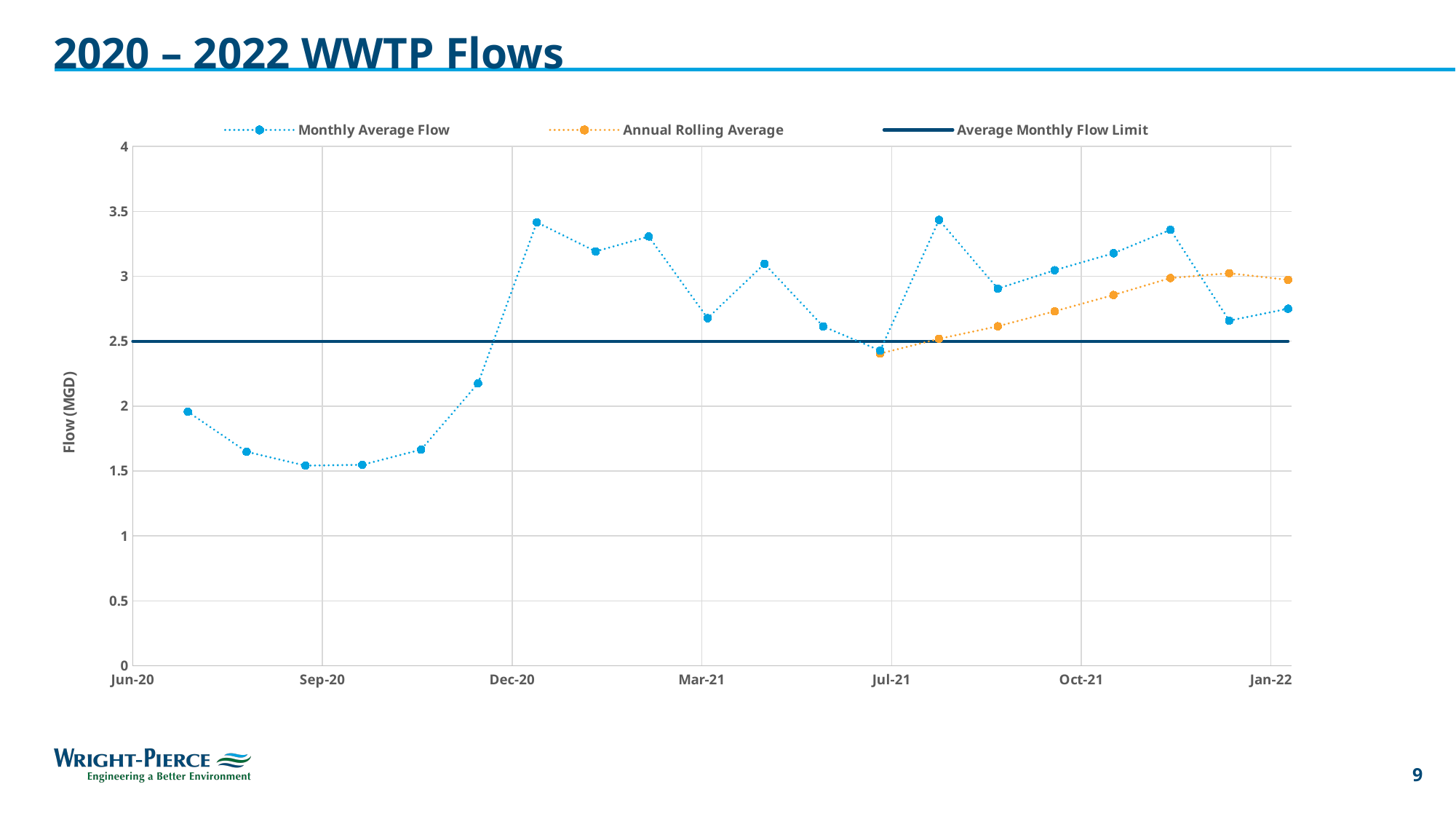
What is the value of the Average Monthly Flow Limit line? 2.5 Is the Monthly Average Flow value at Sep-20 greater or less than 2? less Is the Annual Rolling Average value at Jan-22 greater or less than 2.5? greater What is the label of the y axis? Flow (MGD) How many data points are plotted for the Annual Rolling Average series? 8 Does the Annual Rolling Average generally rise or fall from Jul-21 to Jan-22? Rise Which is larger, the Monthly Average Flow at Dec-20 or at Sep-20? Dec-20 What kind of chart is shown on the slide? Line chart Is the Monthly Average Flow value at Dec-20 greater or less than 3? greater How many series does the legend list? 3 Which series is plotted with orange markers? Annual Rolling Average